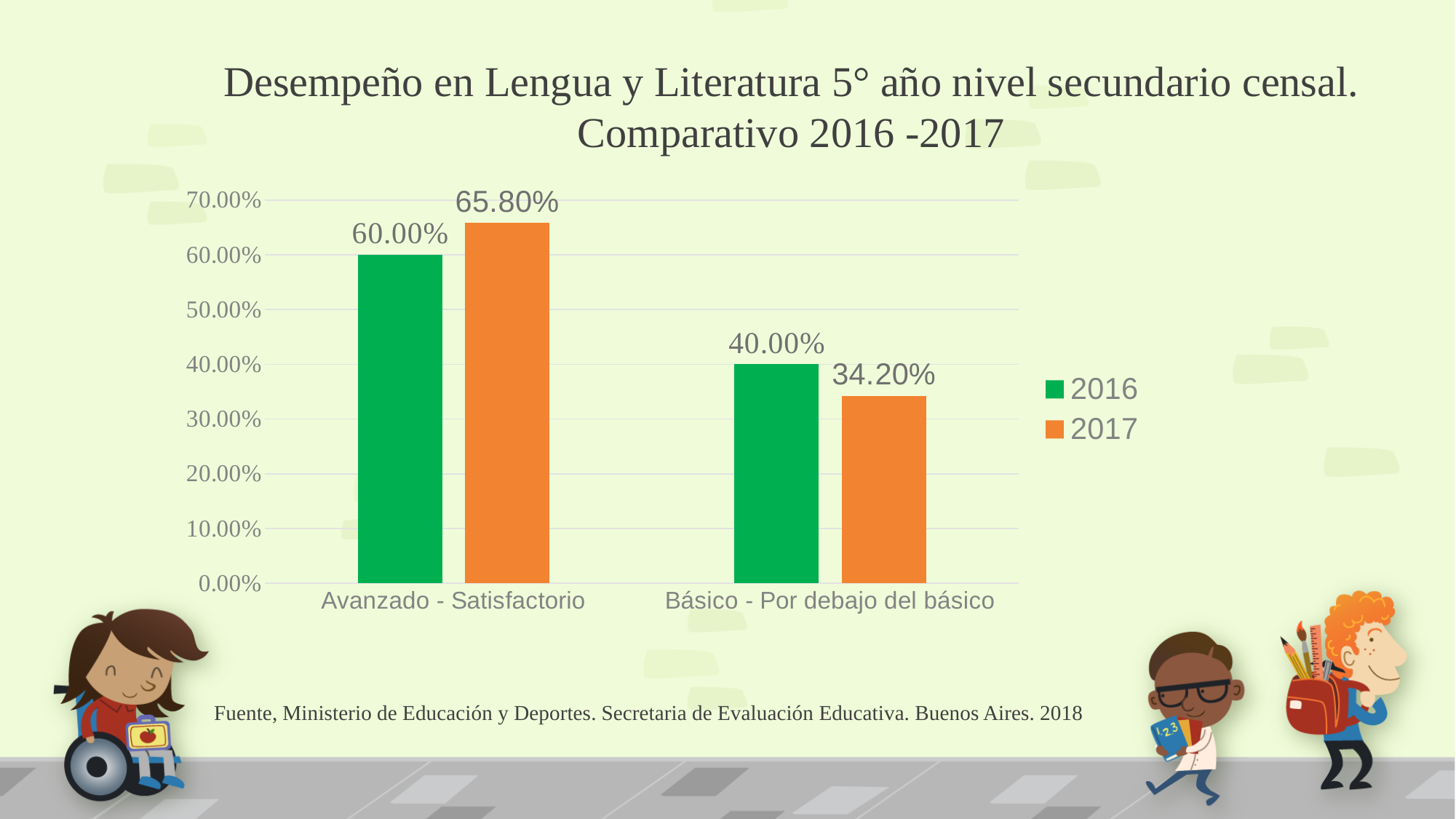
Which bar has the lowest value on the chart? 2017, Básico - Por debajo del básico What kind of chart is shown on the slide? Bar chart What is the value for 2016 in the Avanzado - Satisfactorio category? 60.00% Which bar has the highest value on the chart? 2017, Avanzado - Satisfactorio What is the value for 2016 in the Básico - Por debajo del básico category? 40.00% Which is larger for Básico - Por debajo del básico: the 2016 value or the 2017 value? 2016 What is the difference between the 2017 and 2016 values for Avanzado - Satisfactorio? 5.80% How many categories are shown on the x axis? 2 What is the difference between the 2016 and 2017 values for Básico - Por debajo del básico? 5.80% What is the value for 2017 in the Básico - Por debajo del básico category? 34.20% How many series does the legend list? 2 What is the value for 2017 in the Avanzado - Satisfactorio category? 65.80%